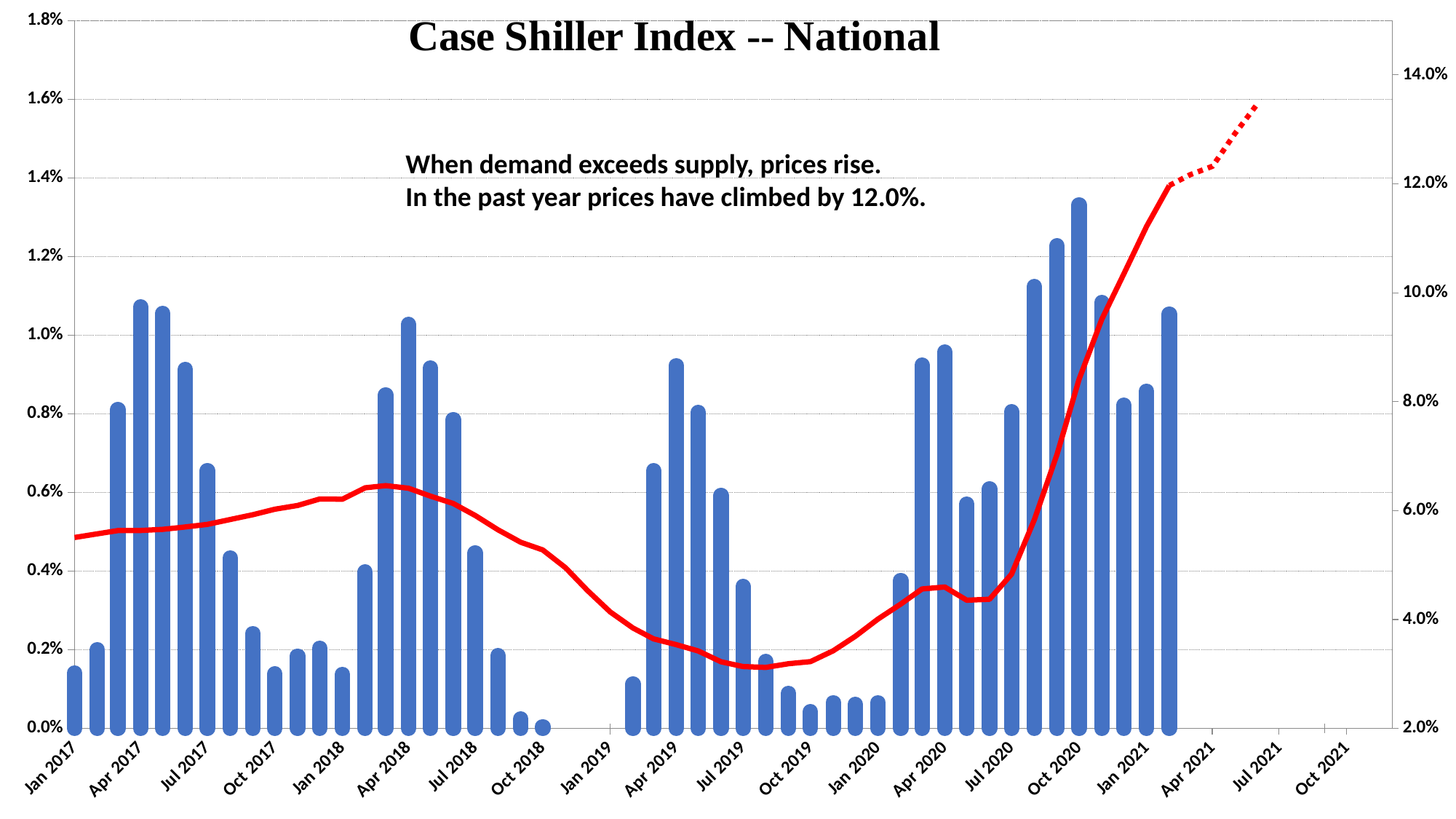
According to the text on the chart, by how much have prices climbed in the past year? 12.0% Is the bar for Jan 2017 greater or less than 0.4% on the left axis? less Does the red line rise or fall between Jul 2020 and Jan 2021? rise Is the red line at Jan 2017 greater or less than 4.0% on the right axis? greater What is the title of the chart? Case Shiller Index -- National What kind of chart is this? Combined bar and line chart What is the highest value shown on the left vertical axis? 1.8% Is the red line at Oct 2019 greater or less than 4.0% on the right axis? less Is the tallest bar in 2017 taller or shorter than the tallest bar in 2020? shorter In which year does the tallest bar on the chart occur? 2020 Does the red line rise or fall between Apr 2018 and Oct 2019? fall